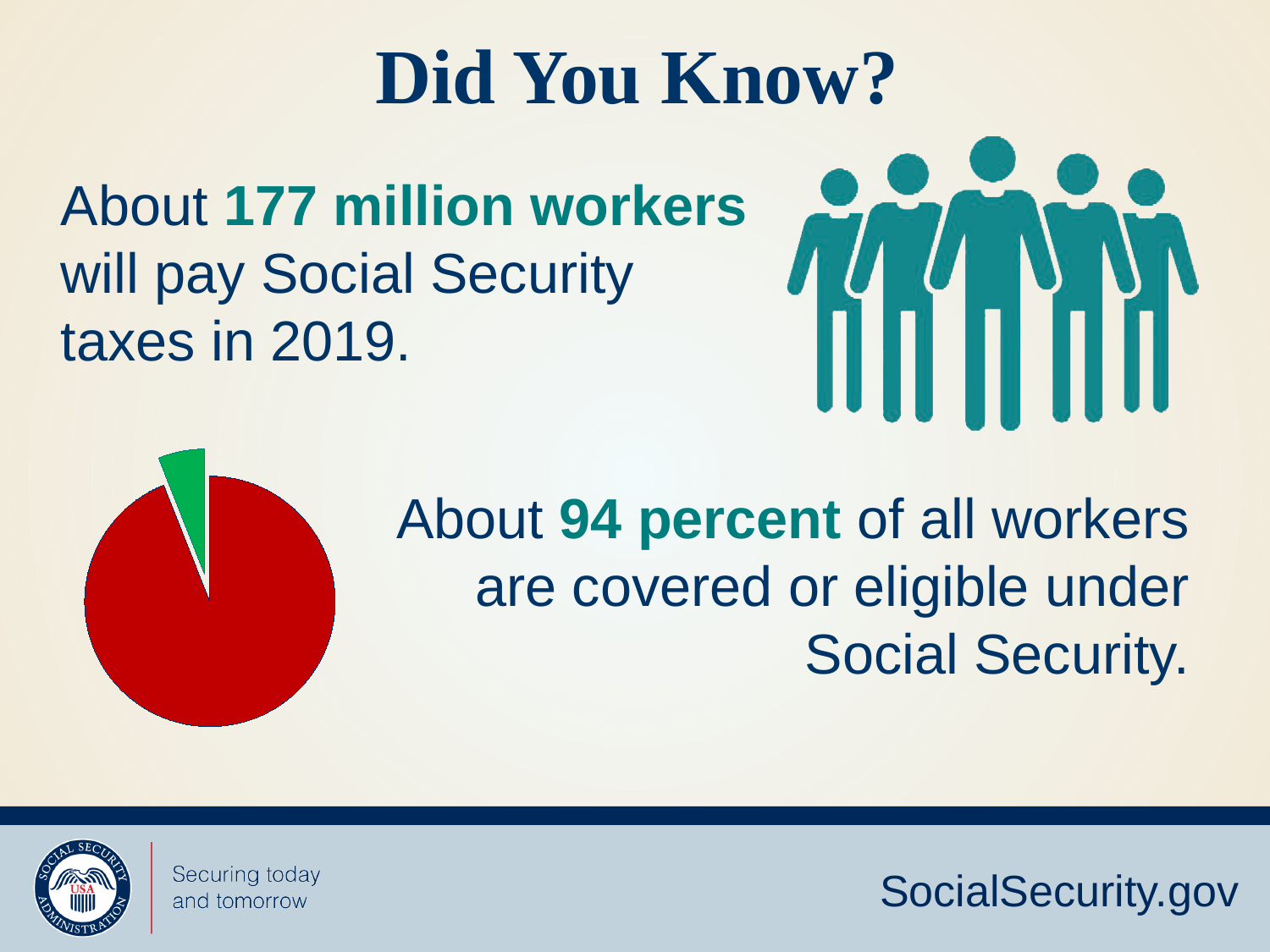
How many slices does the pie chart have? 2 According to the slide text, what share of all workers does the large red slice of the pie represent? 94 percent Which slice of the pie chart is the smallest? the green slice What colour is the small exploded slice of the pie chart? green Is the red slice of the pie chart greater or less than 50% of the pie? greater Which slice of the pie chart is the largest? the red slice Does the pie chart have a legend? No What kind of chart is shown on the slide? pie chart Is the green slice of the pie chart greater or less than 25% of the pie? less Which slice of the pie chart is larger, the red one or the green one? red